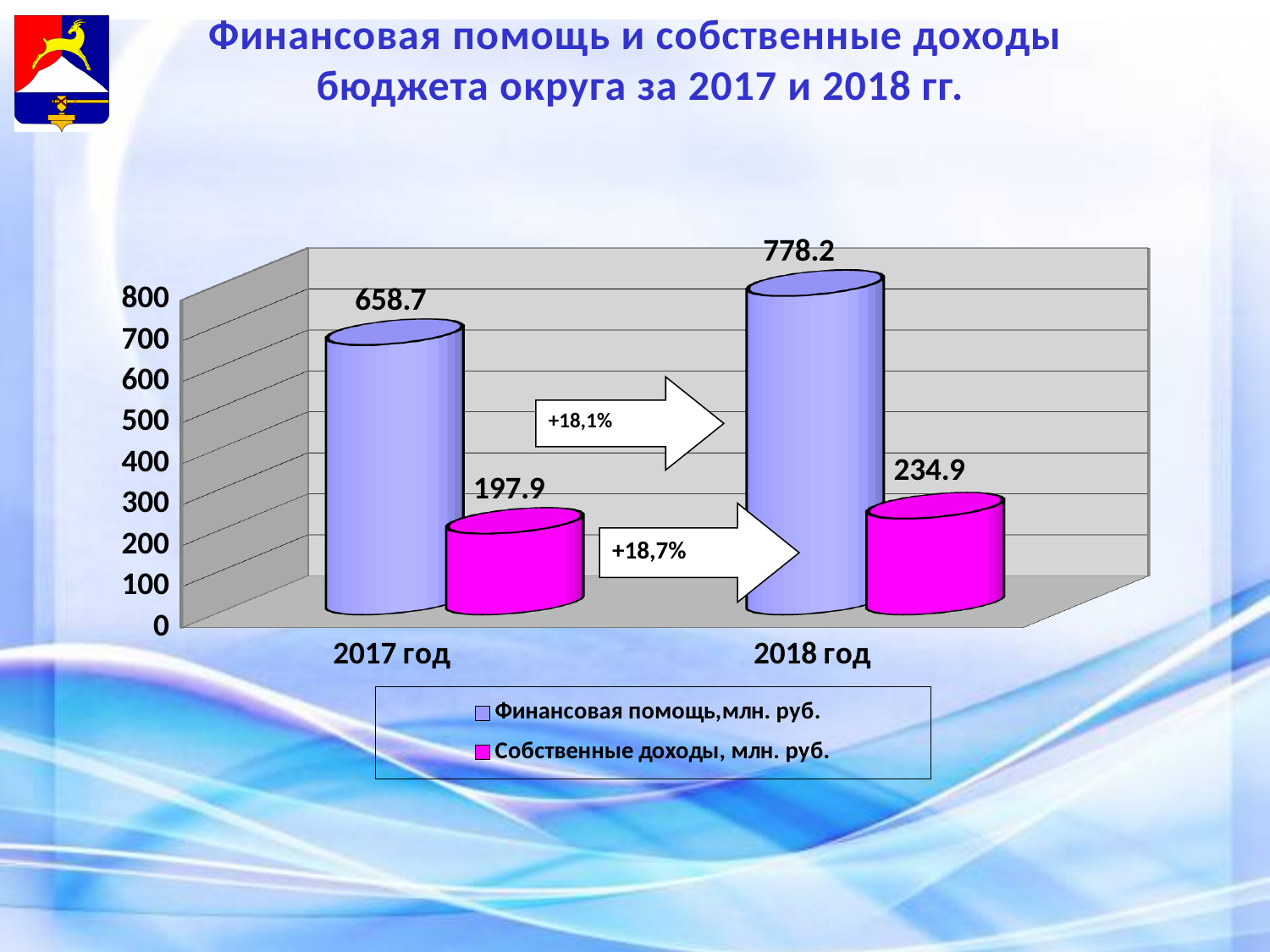
What is the value of Финансовая помощь for 2018 год? 778.2 What kind of chart is shown on the slide? Bar chart What percentage growth is shown by the arrow for Финансовая помощь between 2017 and 2018? +18,1% What is the value of Собственные доходы for 2018 год? 234.9 What is the value of Финансовая помощь for 2017 год? 658.7 What is the value of Собственные доходы for 2017 год? 197.9 How many categories are shown on the x axis? 2 How many series does the legend list? 2 By how much did Финансовая помощь increase from 2017 год to 2018 год? 119.5 Which year has the higher value of Собственные доходы? 2018 год Which is larger in 2018 год: Финансовая помощь or Собственные доходы? Финансовая помощь By how much did Собственные доходы increase from 2017 год to 2018 год? 37.0